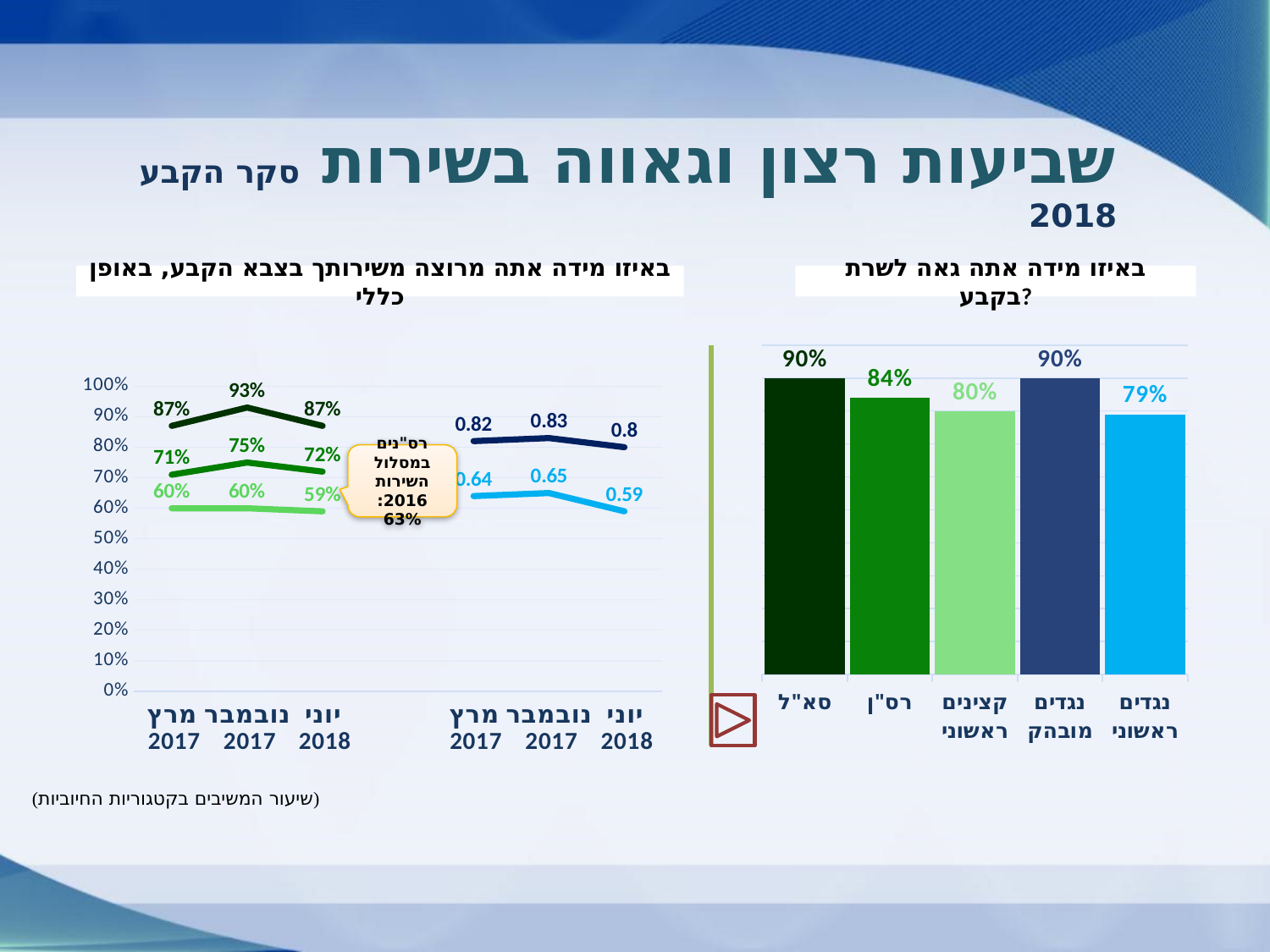
What kind of chart is the chart on the left of the slide (באיזו מידה אתה מרוצה משירותך בצבא הקבע)? Line chart In the bar chart on the right (באיזו מידה אתה גאה לשרת בקבע?), what is the value for רס"ן? 84% In the bar chart on the right, which two categories share the highest value of 90%? סא"ל and נגדים מובהק In the bar chart on the right, which is larger: the value for רס"ן or for קצינים ראשוני? רס"ן In the bar chart on the right, what is the difference between the values for סא"ל and רס"ן? 6 percentage points In the bar chart on the right, what is the value for קצינים ראשוני? 80% In the bar chart on the right, what is the value for נגדים ראשוני? 79% How many categories are shown in the bar chart on the right? 5 In the line chart on the left, what is the highest data label shown? 93% In the bar chart on the right, which category has the lowest value? נגדים ראשוני In the line chart on the left, what is the maximum value shown on the vertical axis? 100% What kind of chart is the chart on the right of the slide? Bar chart